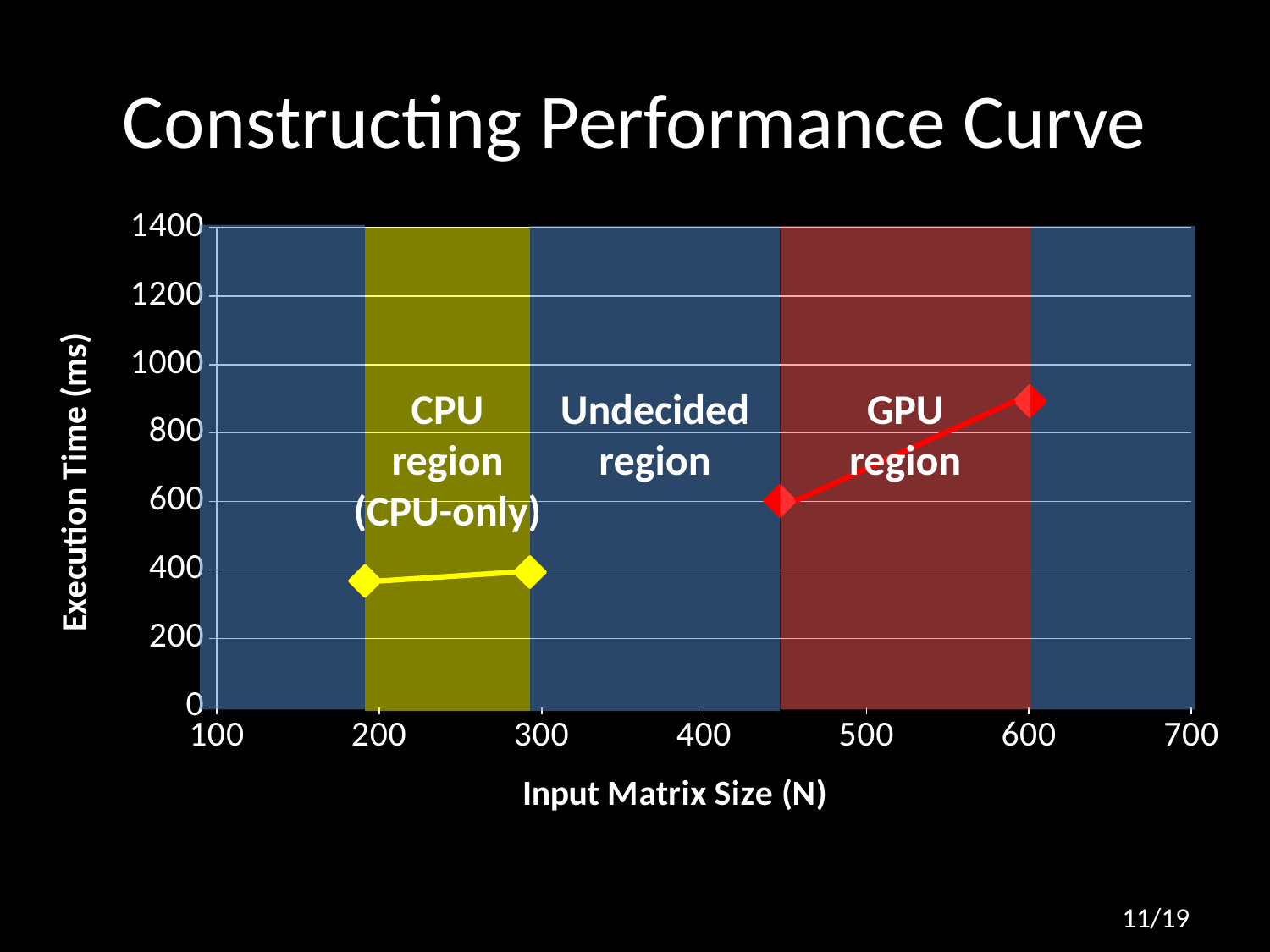
What is the title of the slide's chart? Constructing Performance Curve What is the label of the vertical axis? Execution Time (ms) Which line shows higher execution times, the yellow (CPU region) line or the red (GPU region) line? red (GPU region) line Does the red (GPU region) line rise or fall as the input matrix size increases? rises How many data points are plotted on the red (GPU region) line? 2 Is the execution time of the yellow (CPU region) line at an input matrix size of about 200 greater or less than 600? less Is the execution time of the red (GPU region) line at an input matrix size of about 450 greater or less than 400? greater Which region is shaded between the CPU region and the GPU region? Undecided region What kind of chart is shown on the slide? line chart How many data points are plotted in total across both lines? 4 Is the execution time of the red (GPU region) line at an input matrix size of about 600 greater or less than 800? greater